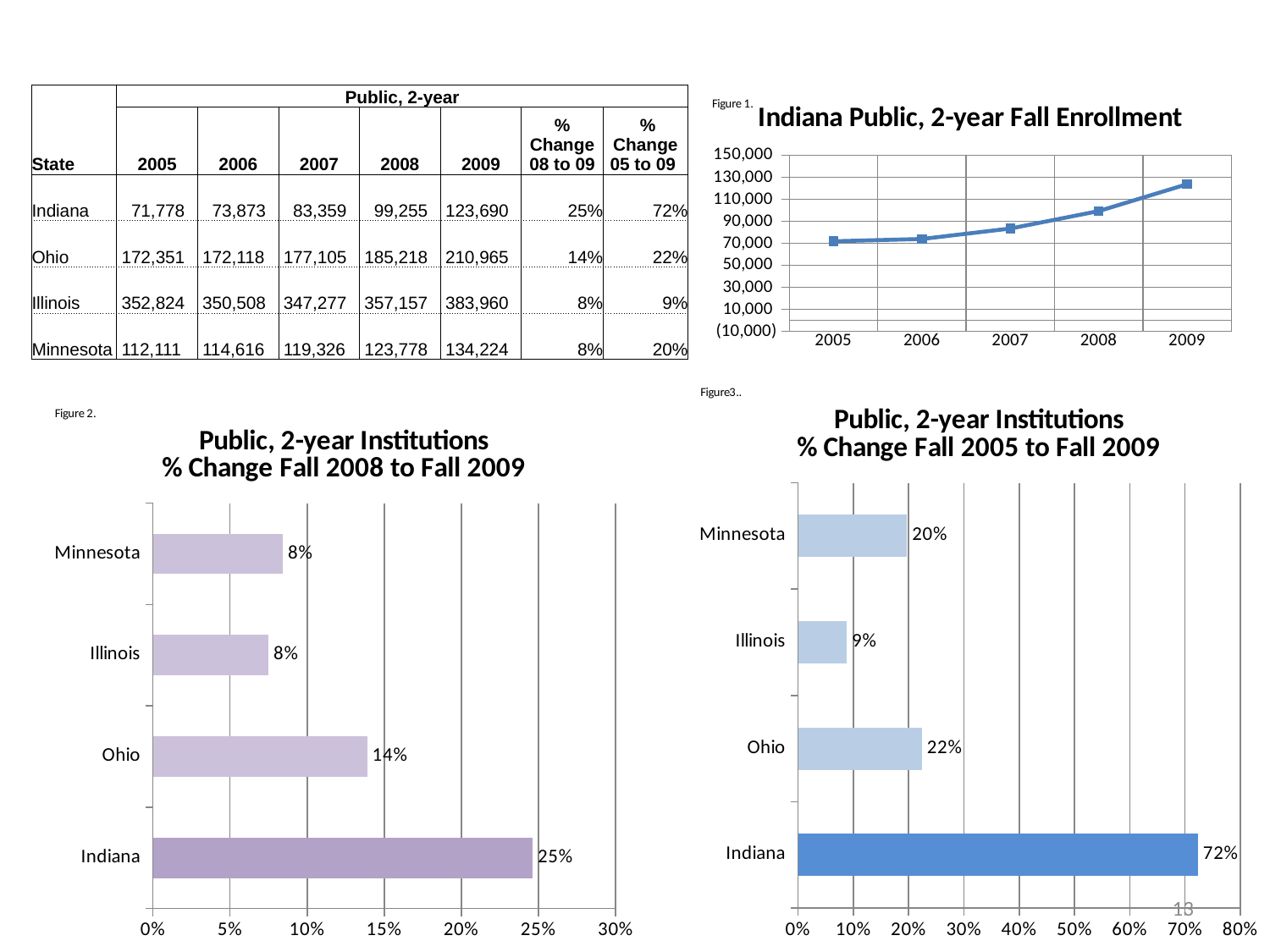
In the chart titled "Public, 2-year Institutions % Change Fall 2005 to Fall 2009", which is larger, the value for Ohio or the value for Minnesota? Ohio In the chart titled "Public, 2-year Institutions % Change Fall 2008 to Fall 2009", what is the value for Indiana? 25% In the chart titled "Indiana Public, 2-year Fall Enrollment", is the value for 2009 greater or less than 110,000? greater In the chart titled "Public, 2-year Institutions % Change Fall 2005 to Fall 2009", what is the value for Minnesota? 20% In the chart titled "Public, 2-year Institutions % Change Fall 2008 to Fall 2009", what is the value for Ohio? 14% In the chart titled "Public, 2-year Institutions % Change Fall 2008 to Fall 2009", what is the difference between the values for Indiana and Ohio? 11% In the chart titled "Public, 2-year Institutions % Change Fall 2005 to Fall 2009", which state has the lowest value? Illinois In the chart titled "Indiana Public, 2-year Fall Enrollment", do the values rise or fall from 2005 to 2009? rise How many states are shown in the chart titled "Public, 2-year Institutions % Change Fall 2005 to Fall 2009"? 4 In the chart titled "Public, 2-year Institutions % Change Fall 2005 to Fall 2009", what is the value for Illinois? 9% In the chart titled "Public, 2-year Institutions % Change Fall 2005 to Fall 2009", what is the difference between the values for Indiana and Ohio? 50% In the chart titled "Public, 2-year Institutions % Change Fall 2008 to Fall 2009", which state has the highest value? Indiana